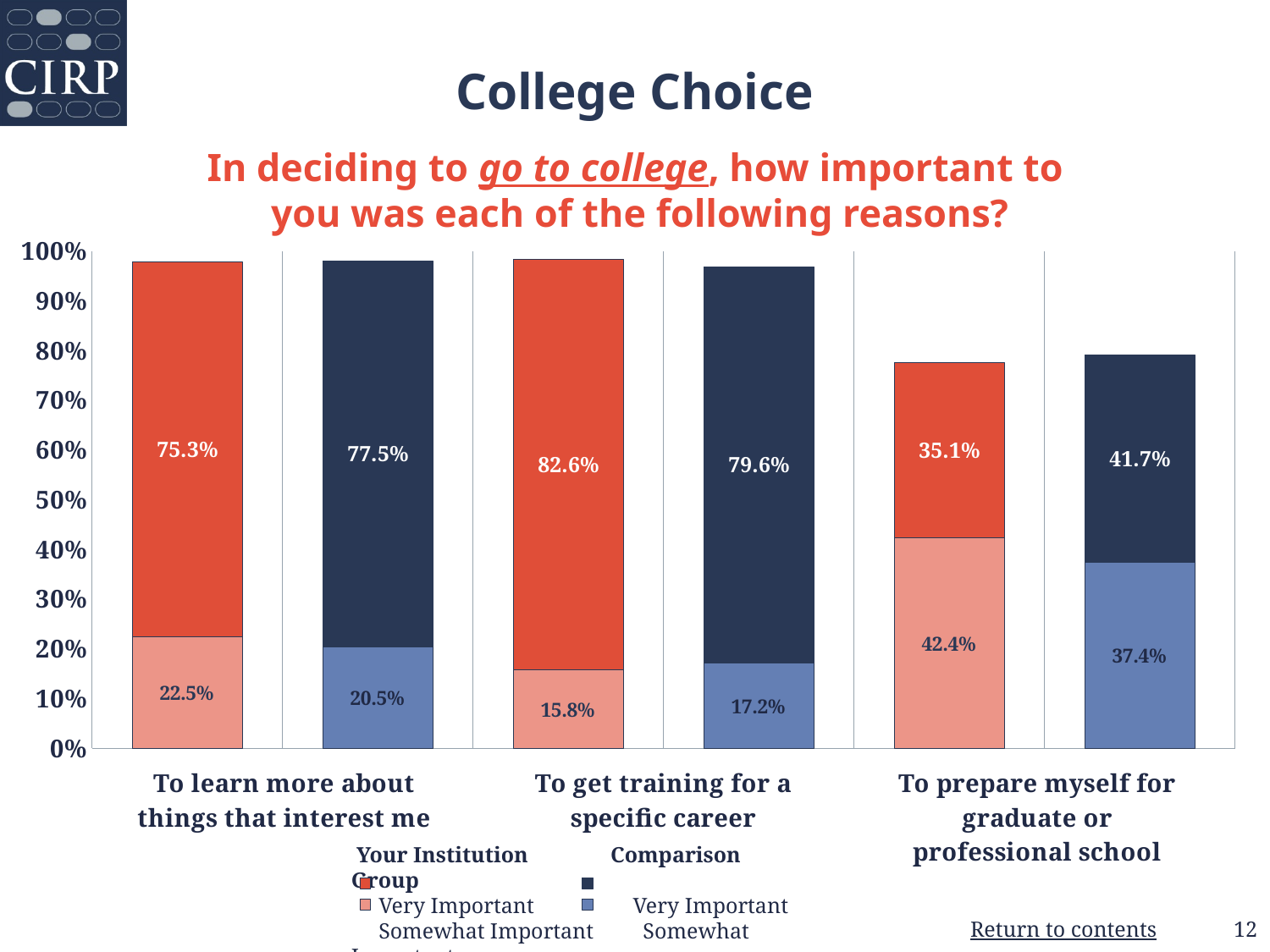
What is the difference between the Comparison Group and Your Institution Very Important percentages for "To prepare myself for graduate or professional school"? 6.6% What kind of chart is shown on the slide? Stacked bar chart For "To learn more about things that interest me", which group has the higher Very Important percentage, Your Institution or the Comparison Group? Comparison Group What percentage of Your Institution students rated "To learn more about things that interest me" as Somewhat Important? 22.5% What is the total of the Comparison Group stacked bar for "To get training for a specific career"? 96.8% What percentage of the Comparison Group rated "To prepare myself for graduate or professional school" as Somewhat Important? 37.4% Which reason has the lowest Very Important percentage for the Comparison Group? To prepare myself for graduate or professional school What is the total of the Your Institution stacked bar for "To prepare myself for graduate or professional school"? 77.5% Which reason has the highest Very Important percentage for Your Institution? To get training for a specific career How many entries does the chart legend list? 4 How many reasons (categories) are shown on the x axis of the chart? 3 What percentage of Your Institution students rated "To get training for a specific career" as Very Important? 82.6%